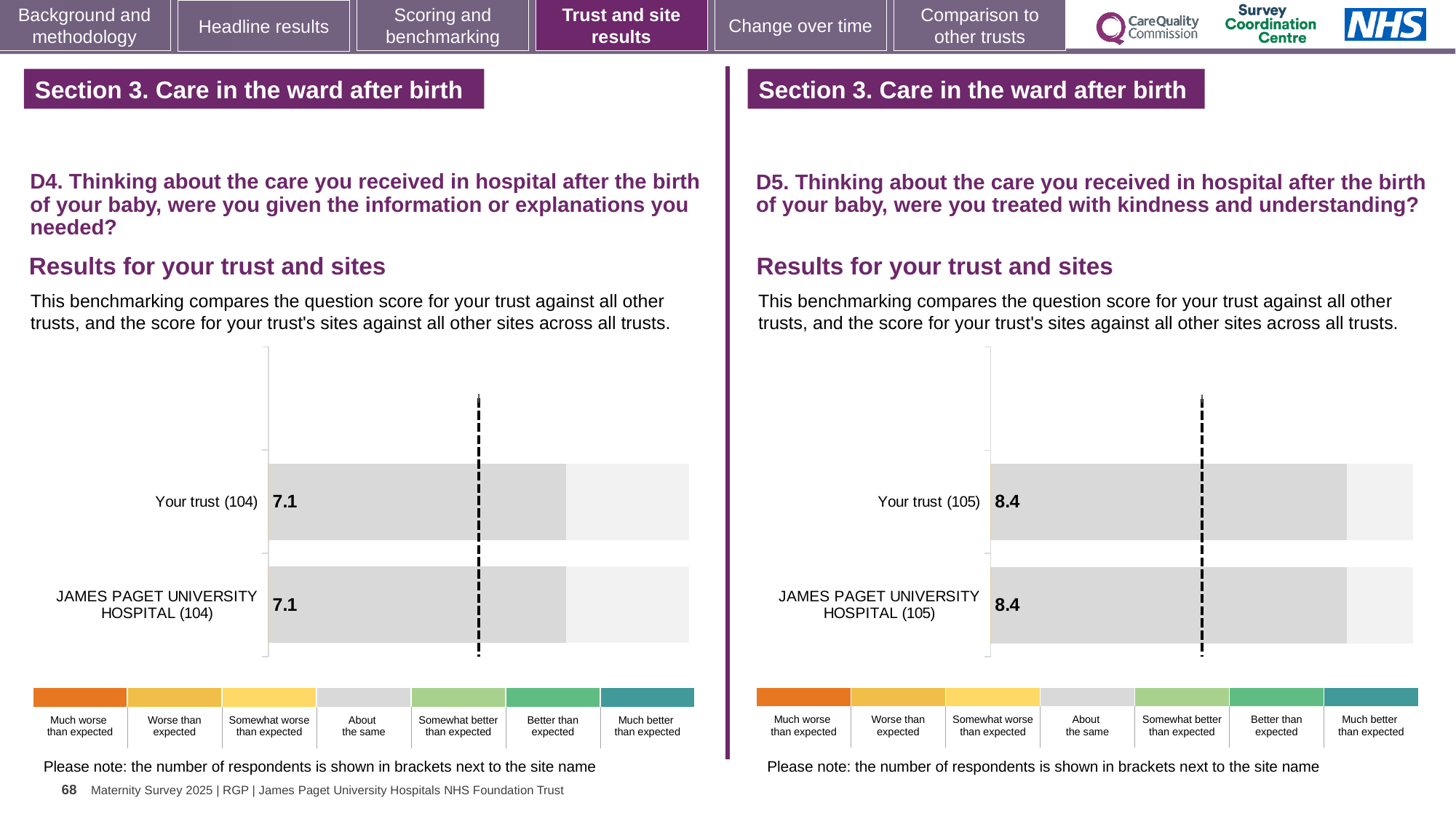
What kind of chart is used for the D5 results on the right? Bar chart In the D5 chart on the right, what is the score for JAMES PAGET UNIVERSITY HOSPITAL? 8.4 In the D4 chart on the left, what is the score for JAMES PAGET UNIVERSITY HOSPITAL? 7.1 How many rating categories does the colour key below the D5 chart on the right list? 7 In the D4 chart on the left, what is the score for Your trust? 7.1 How many bars are plotted in the D5 chart on the right? 2 In the D4 chart on the left, how many respondents are shown in brackets next to Your trust? 104 Is the Your trust score in the D5 chart on the right larger or smaller than the Your trust score in the D4 chart on the left? Larger How many bars are plotted in the D4 chart on the left? 2 In the D5 chart on the right, what is the difference between the score for Your trust and the score for JAMES PAGET UNIVERSITY HOSPITAL? 0 In the D4 chart on the left, what is the difference between the score for Your trust and the score for JAMES PAGET UNIVERSITY HOSPITAL? 0 In the D5 chart on the right, what is the score for Your trust? 8.4